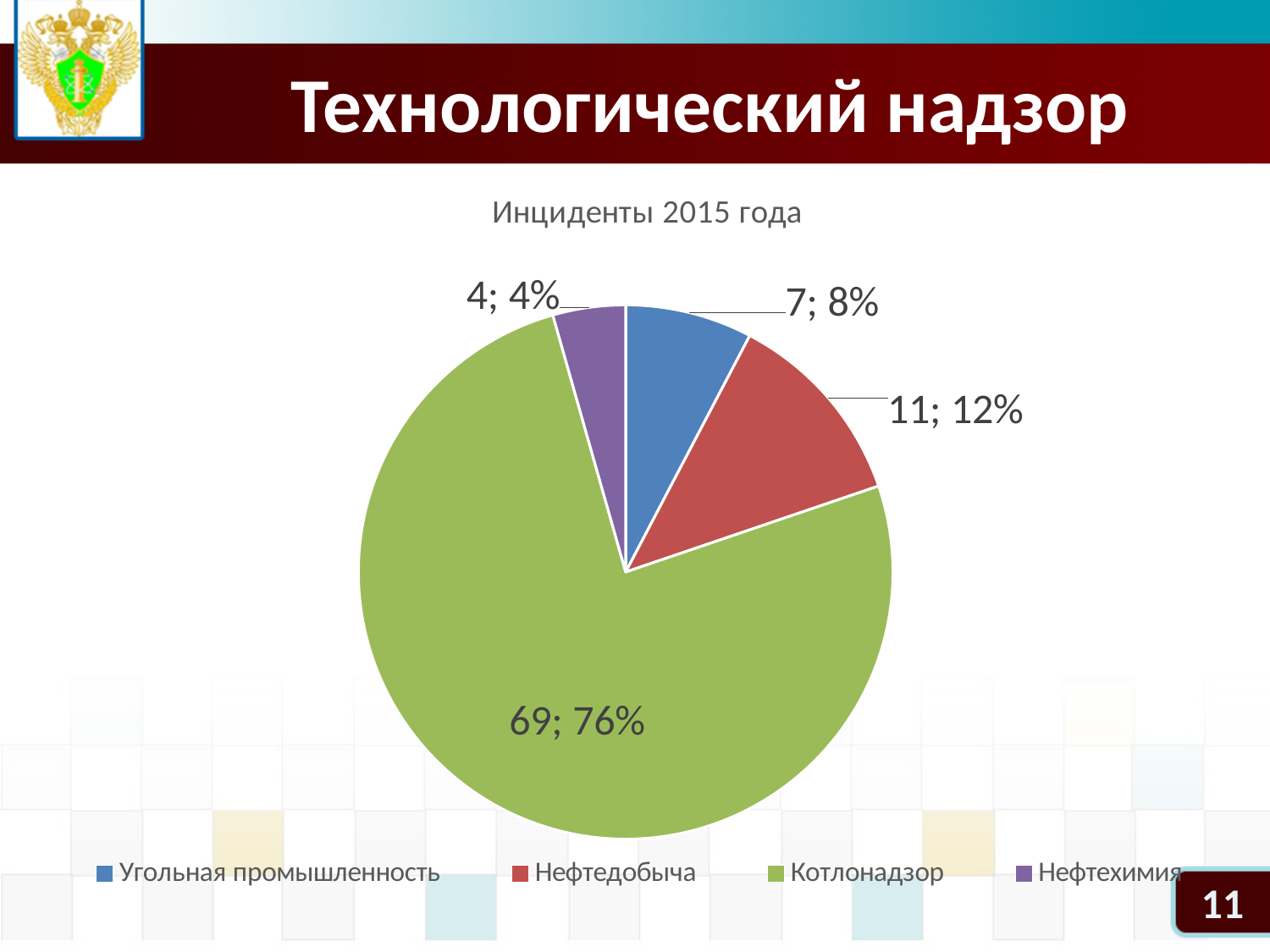
How many slices does the pie chart have? 4 What is the number of incidents for Угольная промышленность? 7 Which category has the largest slice? Котлонадзор What is the title of the chart? Инциденты 2015 года How many entries does the legend list? 4 What is the number of incidents for Нефтедобыча? 11 What share of the pie does Нефтехимия represent? 4% What is the number of incidents for Котлонадзор? 69 What share of the pie does Котлонадзор represent? 76% What is the difference between the number of incidents for Нефтедобыча and Угольная промышленность? 4 Which category has the smallest slice? Нефтехимия What kind of chart is shown on the slide? Pie chart